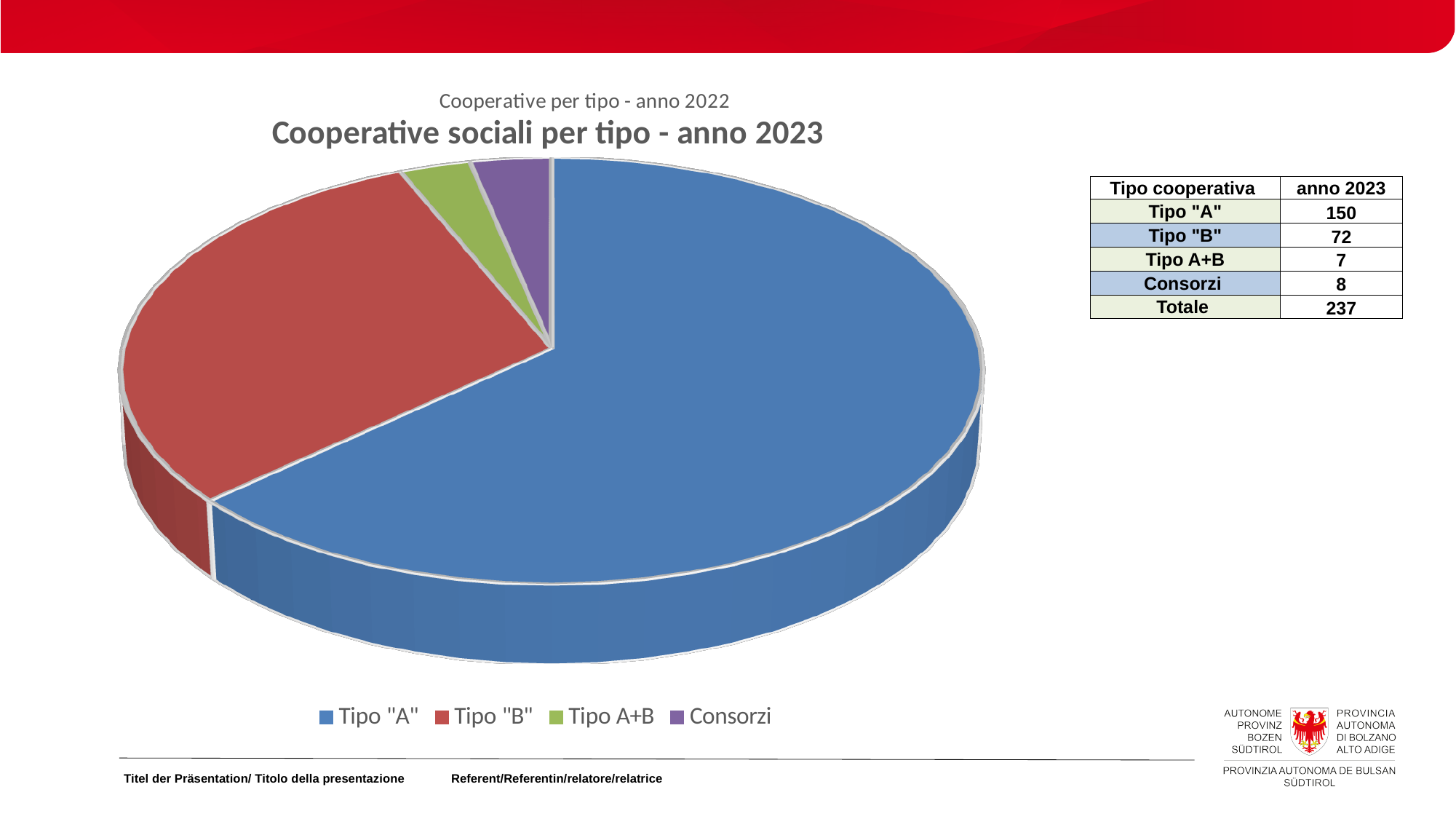
Which is larger, the value for Tipo "B" or the value for Consorzi? Tipo "B" What is the value for Tipo "B" in anno 2023? 72 What is the difference between the values for Tipo "A" and Tipo "B"? 78 What colour is the Tipo "A" slice in the pie chart? blue What is the total of all categories shown in the table? 237 Which category has the smallest value? Tipo A+B What is the value for Tipo "A" in anno 2023? 150 What kind of chart is shown on the slide? pie chart Which category has the largest slice of the pie? Tipo "A" What is the value for Tipo A+B in anno 2023? 7 What is the value for Consorzi in anno 2023? 8 How many categories does the pie chart show? 4